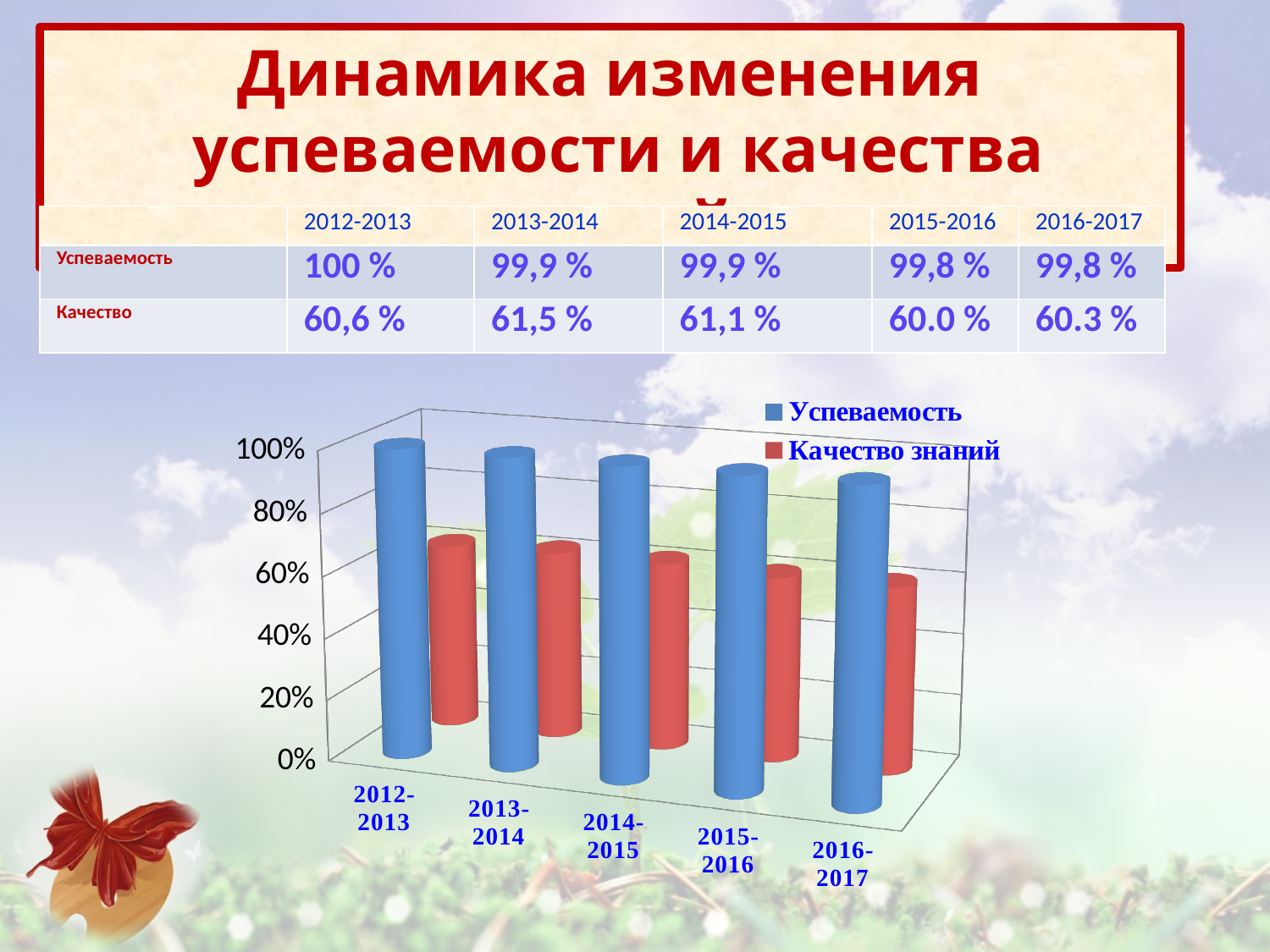
According to the table on the slide, in which school year is Качество highest? 2013-2014 In the chart, is the value of Успеваемость for 2016-2017 greater or less than 80%? greater In the chart, is the value of Качество знаний for 2012-2013 greater or less than 40%? greater In the chart, which series has the larger value for 2014-2015, Успеваемость or Качество знаний? Успеваемость What kind of chart is shown on the slide? bar chart According to the table on the slide, in which school year is Качество lowest? 2015-2016 Does the value of Успеваемость rise or fall from 2012-2013 to 2016-2017? fall How many school-year categories are plotted along the x axis of the chart? 5 According to the table on the slide, what is the value of Качество for 2013-2014? 61,5 % What are the two entries in the chart legend? Успеваемость, Качество знаний According to the table on the slide, what is the value of Успеваемость for 2012-2013? 100 % How many series does the chart legend list? 2